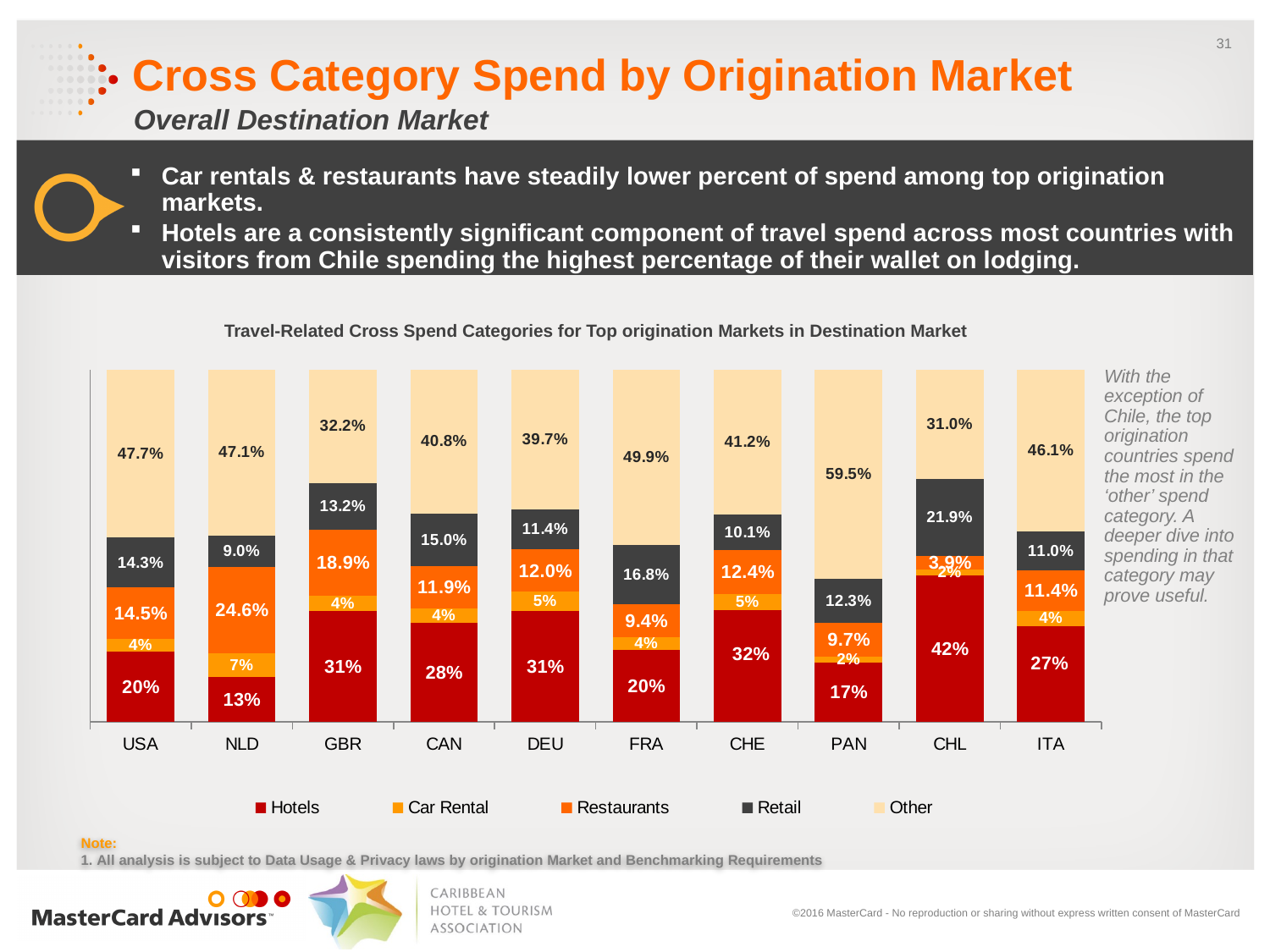
Which has a larger Restaurants share, NLD or GBR? NLD What is the Retail share for FRA? 16.8% What is the Hotels share for CHL? 42% How many series does the legend list? 5 Which origination market has the lowest Hotels share? NLD What is the Other share for PAN? 59.5% Which origination market has the highest Hotels share? CHL How many origination markets are shown on the x axis? 10 What is the difference in Hotels share between CHL and NLD? 29 percentage points What is the Restaurants share for NLD? 24.6% Which origination market has the lowest Other share? CHL What kind of chart is shown on the slide? Stacked bar chart